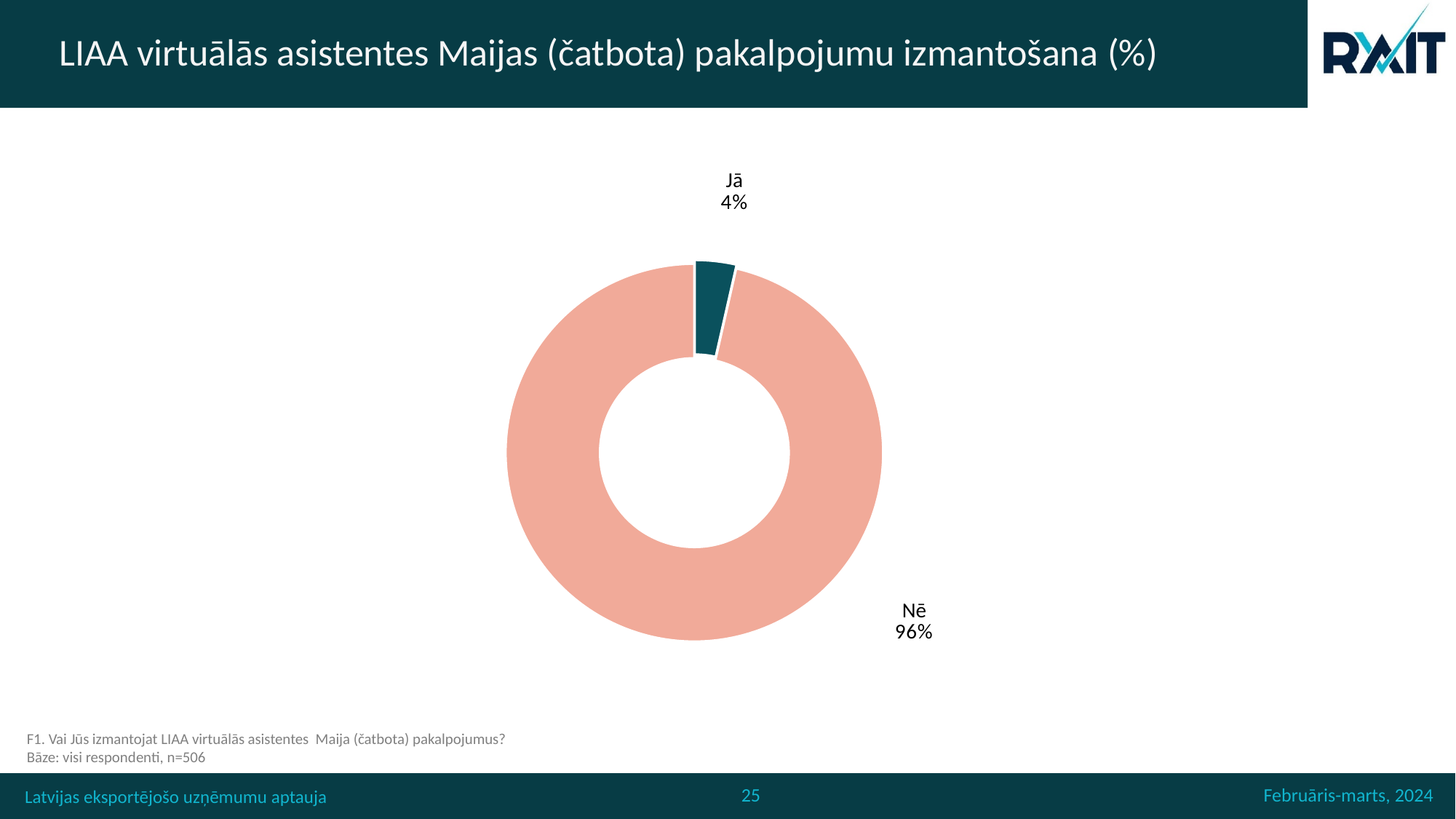
What percentage of respondents answered "Nē" in the chart? 96% What colour is the "Nē" slice in the chart? Salmon pink What share of the pie does the "Jā" slice represent? 4% What kind of chart is shown on the slide? Doughnut (pie) chart Which category has the smallest share in the chart? Jā What is the title of the chart on the slide? LIAA virtuālās asistentes Maijas (čatbota) pakalpojumu izmantošana (%) Which is larger, the share for "Jā" or the share for "Nē"? Nē What percentage of respondents answered "Jā" in the chart? 4% Which category has the largest share in the chart? Nē How many categories are shown in the chart? 2 What is the difference in percentage points between "Nē" and "Jā"? 92 percentage points